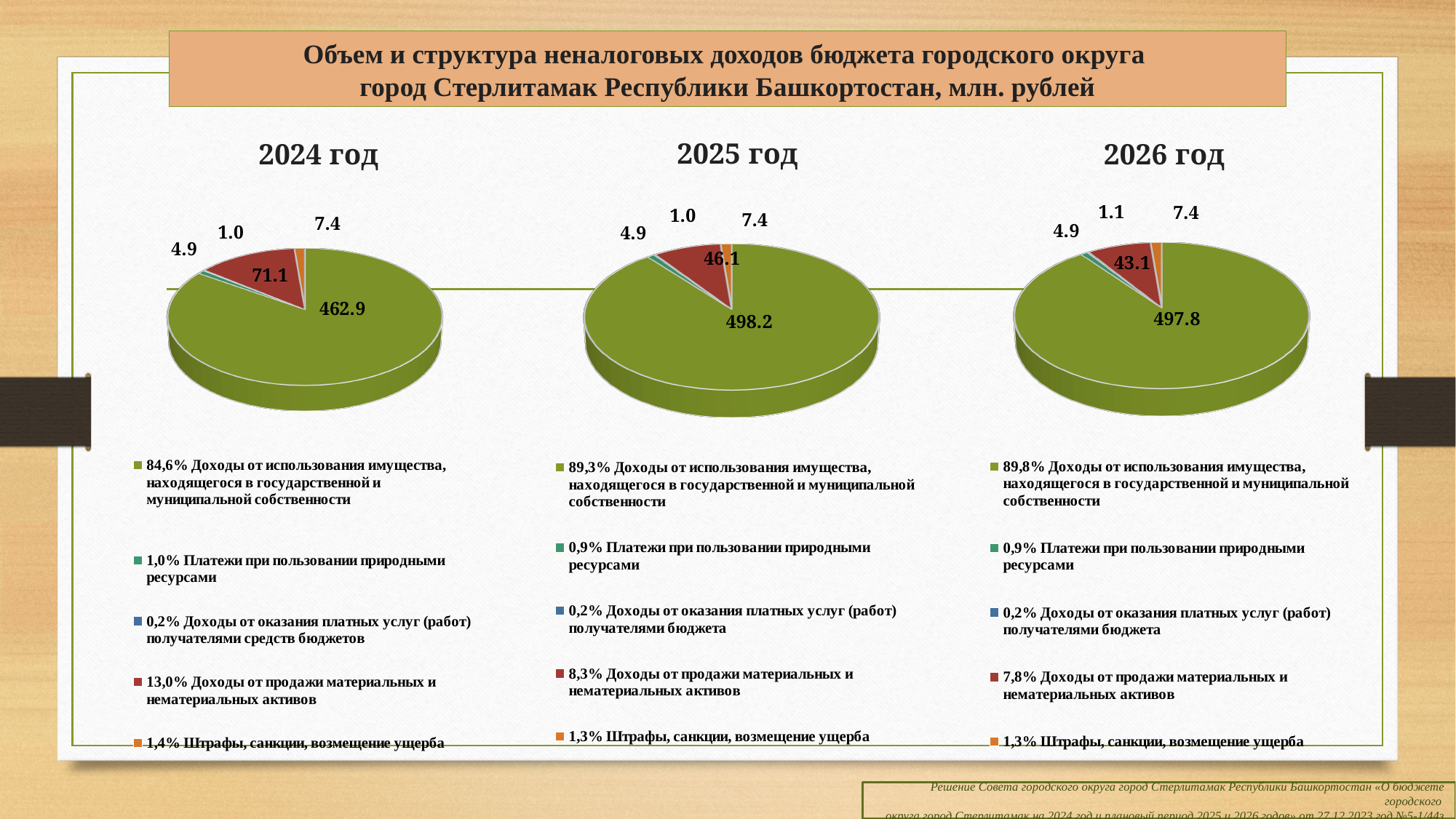
In the 2024 год pie chart, what is the value of the largest slice (income from use of property)? 462.9 According to the legend of the 2026 год chart, what share is 'Доходы от продажи материальных и нематериальных активов'? 7,8% What colour is the slice for 'Штрафы, санкции, возмещение ущерба' in the pie charts? Orange In the 2026 год pie chart, what is the value of the largest slice? 497.8 How many slices does each pie chart have? 5 How many pie charts are on the slide? 3 In the 2024 год pie chart, what is the difference between the largest slice (462.9) and the red slice (71.1)? 391.8 In the 2024 год pie chart, what is the value of the red slice (income from sale of assets)? 71.1 According to the legend of the 2025 год chart, what share of non-tax income comes from use of state and municipal property? 89,3% What type of charts are shown on the slide? Pie charts Which is larger: the red slice in the 2024 год chart or the red slice in the 2026 год chart? 2024 год (71.1) In the 2025 год pie chart, what is the value of the red slice (income from sale of material and non-material assets)? 46.1